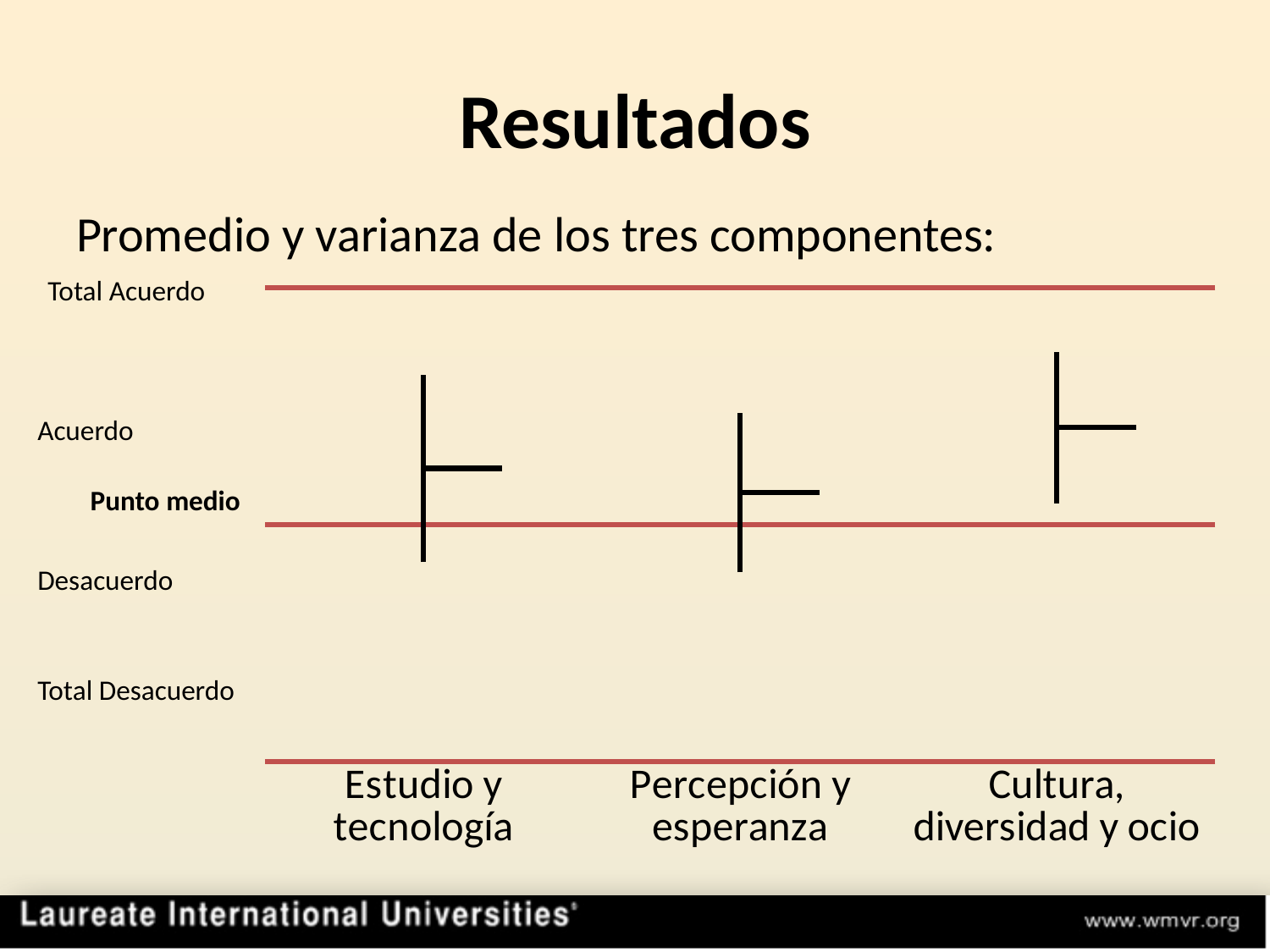
Which component's variance range lies entirely above the Punto medio line? Cultura, diversidad y ocio How many components (categories) are plotted on the chart? 3 Is the mean for Estudio y tecnología above or below the Punto medio line? above What is the topmost label on the vertical scale of the chart? Total Acuerdo Which has the higher mean: Cultura, diversidad y ocio or Estudio y tecnología? Cultura, diversidad y ocio Which component has the highest mean (promedio) on the chart? Cultura, diversidad y ocio Which has the higher mean: Estudio y tecnología or Percepción y esperanza? Estudio y tecnología What is the label of the category on the far right of the x axis? Cultura, diversidad y ocio Do the means rise or fall from Estudio y tecnología to Percepción y esperanza? fall Which component has the lowest mean (promedio) on the chart? Percepción y esperanza Is the mean for Percepción y esperanza above or below the Punto medio line? above Which component shows the widest variance range (longest vertical line)? Estudio y tecnología